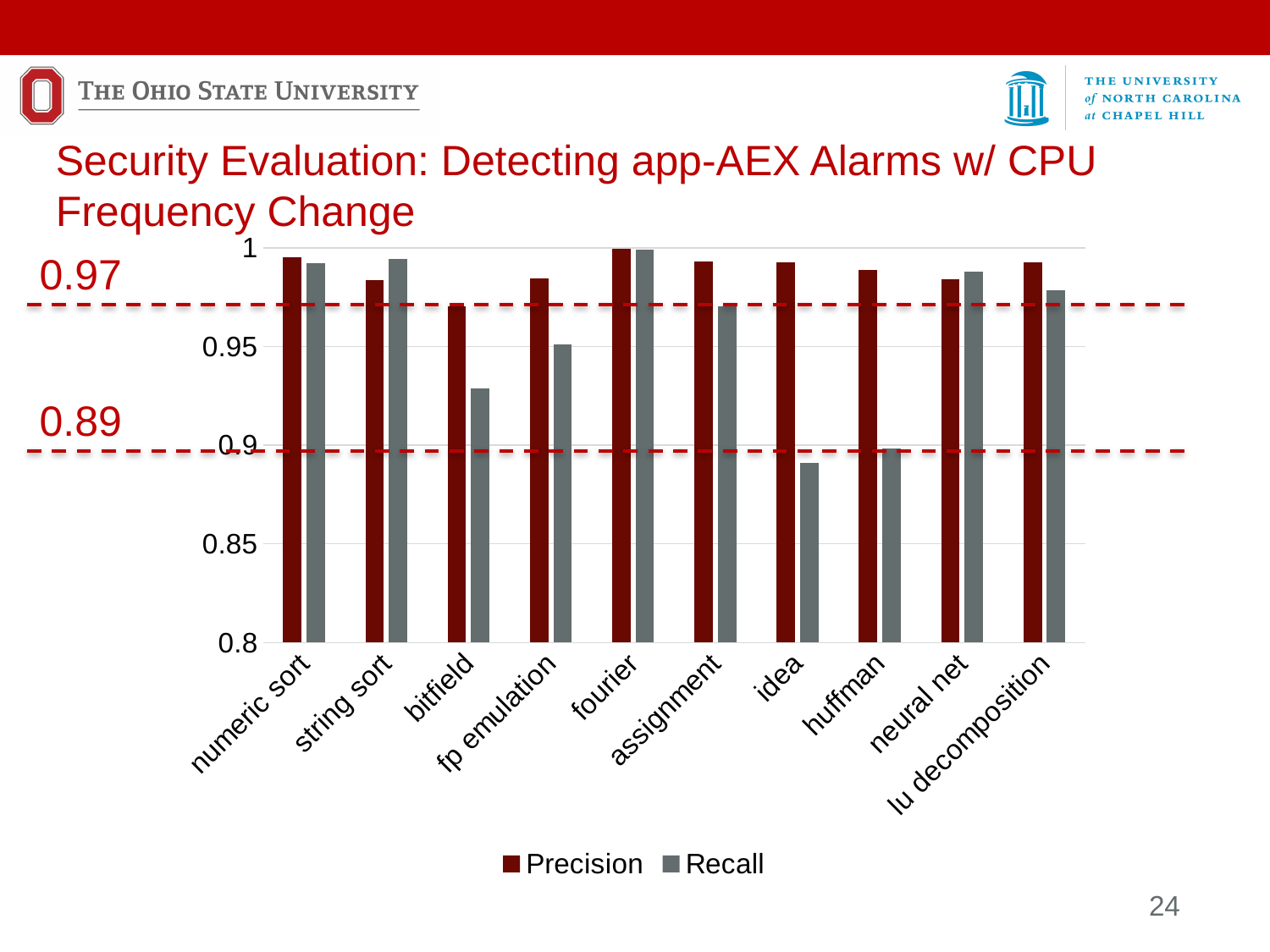
What values are marked by the two dashed horizontal lines on the chart? 0.97 and 0.89 How many series does the chart's legend list? 2 How many benchmark categories are shown on the x axis of the chart? 10 Which category has the lowest Precision value? bitfield Is the Recall value for numeric sort greater or less than 0.95? greater Is the Recall value for bitfield greater or less than 0.9? greater For bitfield, which is larger, Precision or Recall? Precision Is the Recall value for idea greater or less than 0.9? less What kind of chart is shown on the slide? bar chart What are the two series named in the chart's legend? Precision and Recall For idea, which is larger, Precision or Recall? Precision